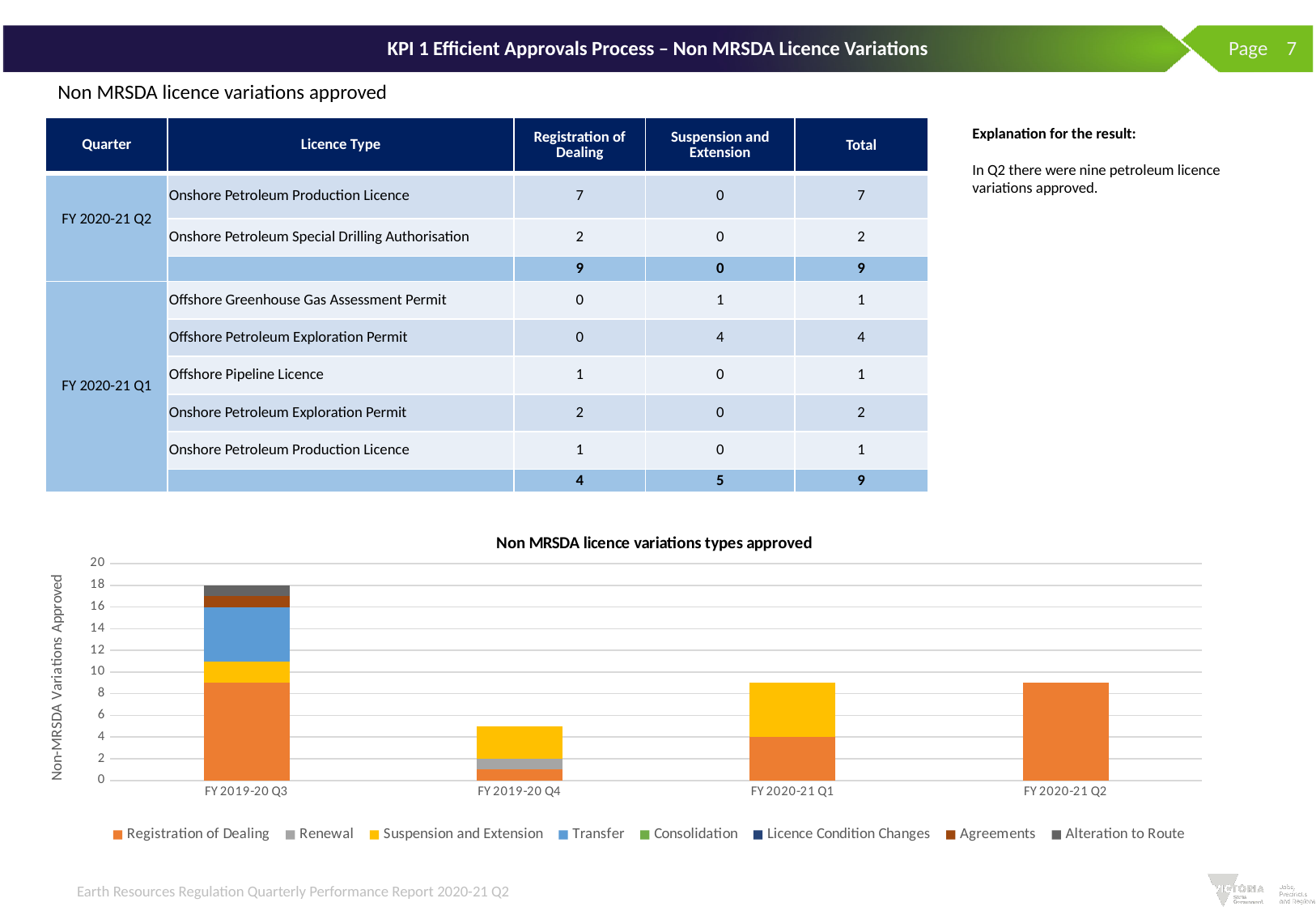
What is the title of the chart? Non MRSDA licence variations types approved How many Registration of Dealing variations were approved in FY 2020-21 Q2? 9 Does the total bar height rise or fall from FY 2019-20 Q4 to FY 2020-21 Q1? rise Which quarter has a taller bar, FY 2019-20 Q4 or FY 2020-21 Q1? FY 2020-21 Q1 Which quarter has the lowest total of non-MRSDA variations approved in the chart? FY 2019-20 Q4 How many Suspension and Extension variations were approved in FY 2020-21 Q1? 5 How many series does the chart legend list? 8 What kind of chart is shown on the slide? Stacked bar chart Which quarter has the highest total of non-MRSDA variations approved in the chart? FY 2019-20 Q3 Is the total bar height for FY 2019-20 Q3 greater or less than 14? greater Is the total bar height for FY 2019-20 Q4 greater or less than 6? less How many quarters are shown on the x axis of the chart? 4